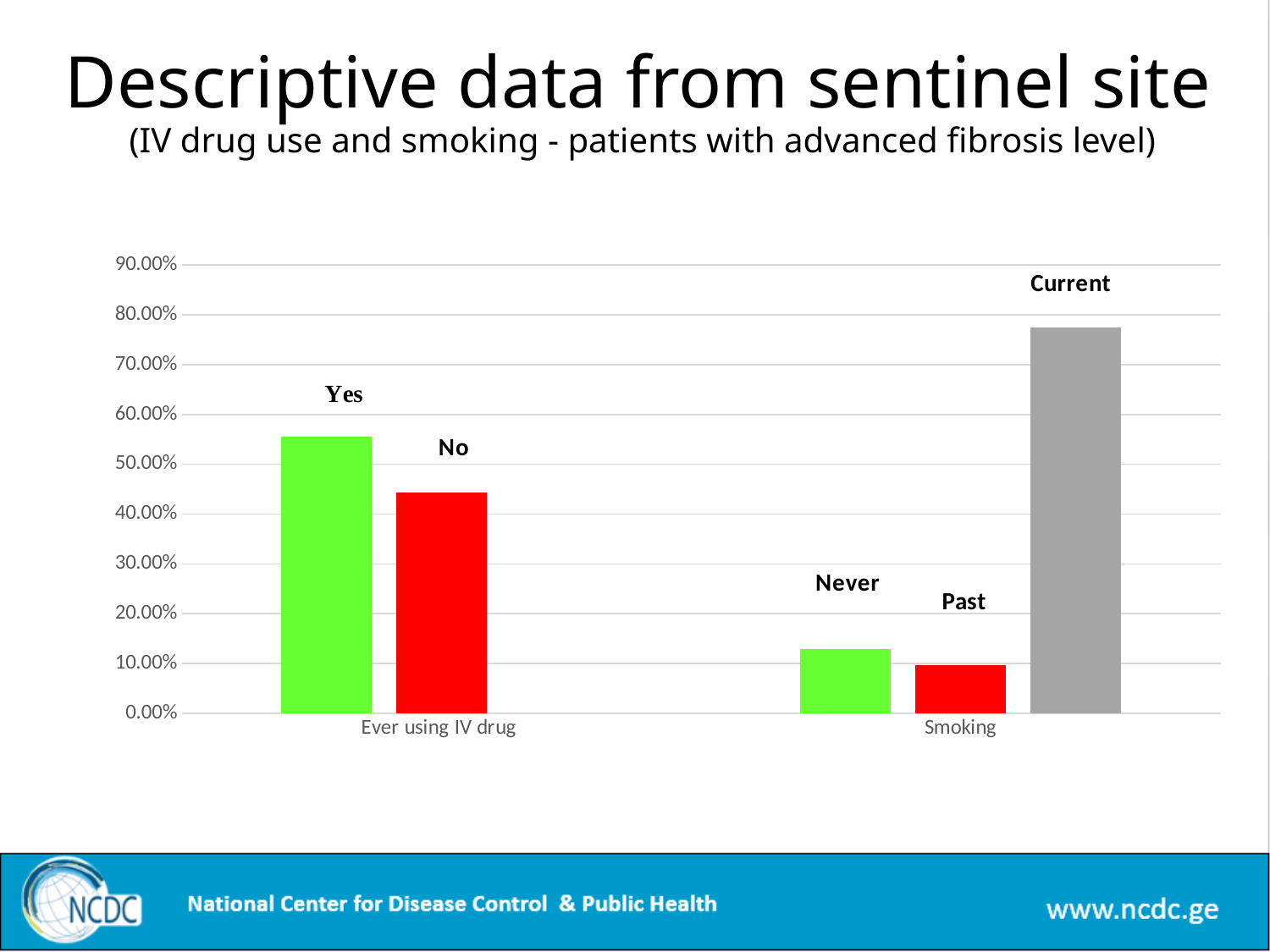
What colour is the 'Current' bar in the Smoking category? grey Which bar is the shortest in the chart? Past Is the value for the 'Yes' bar under 'Ever using IV drug' greater or less than 50.00%? greater What kind of chart is shown on the slide? bar chart Within the 'Ever using IV drug' category, which bar is taller, Yes or No? Yes What is the highest value shown on the y axis? 90.00% Is the value for the 'Current' smoking bar greater or less than 70.00%? greater How many categories are labelled on the x axis? 2 Within the 'Smoking' category, which bar is taller, Never or Past? Never Which bar is the tallest in the chart? Current Is the value for the 'No' bar under 'Ever using IV drug' greater or less than 50.00%? less